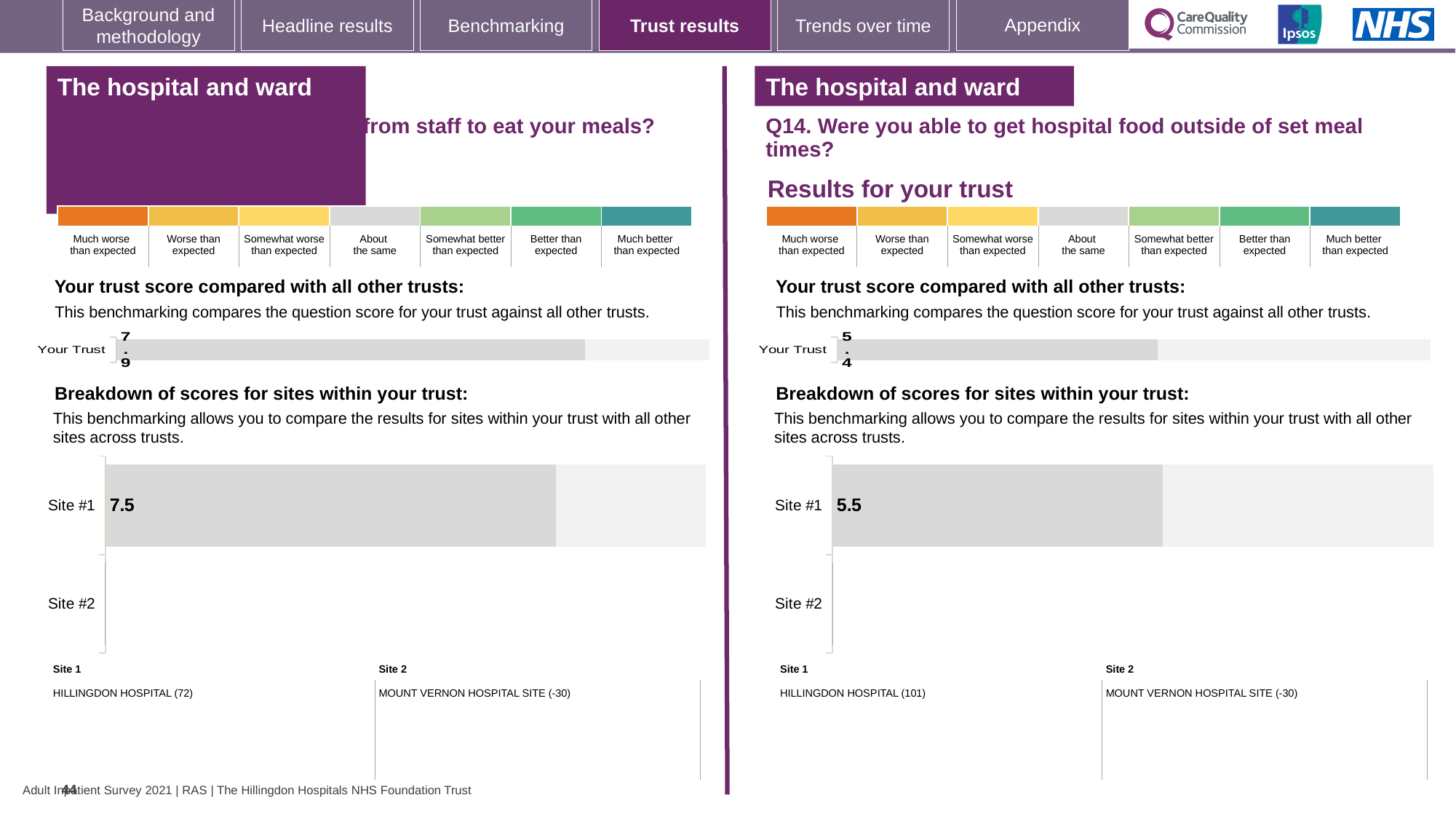
What type of chart is used to show the breakdown of scores for sites within your trust? Bar chart On the left-hand side of the slide, what is the score shown for Your Trust in the 'Your trust score compared with all other trusts' chart? 7.9 What is the difference between the Your Trust score on the left (7.9) and the Your Trust score on the right (5.4)? 2.5 On the right-hand side of the slide (Q14), what is the score shown for Your Trust in the 'Your trust score compared with all other trusts' chart? 5.4 What is the difference between the Site #1 score in the left-hand breakdown chart (7.5) and the Site #1 score in the right-hand breakdown chart (5.5)? 2.0 In the right-hand breakdown chart (Q14), is the Site #1 score greater or less than the Your Trust score of 5.4? greater In the left-hand 'Breakdown of scores for sites within your trust' chart, what is the score for Site #1? 7.5 According to the site key on the right-hand side of the slide, which hospital is Site 1? HILLINGDON HOSPITAL (101) Which is larger: the Site #1 score in the left-hand breakdown chart or the Site #1 score in the right-hand breakdown chart? Left-hand chart (7.5) In the right-hand breakdown chart (Q14), which site has no bar or score displayed? Site #2 In the right-hand 'Breakdown of scores for sites within your trust' chart (Q14), what is the score for Site #1? 5.5 How many sites are listed as categories in the right-hand 'Breakdown of scores for sites within your trust' chart? 2